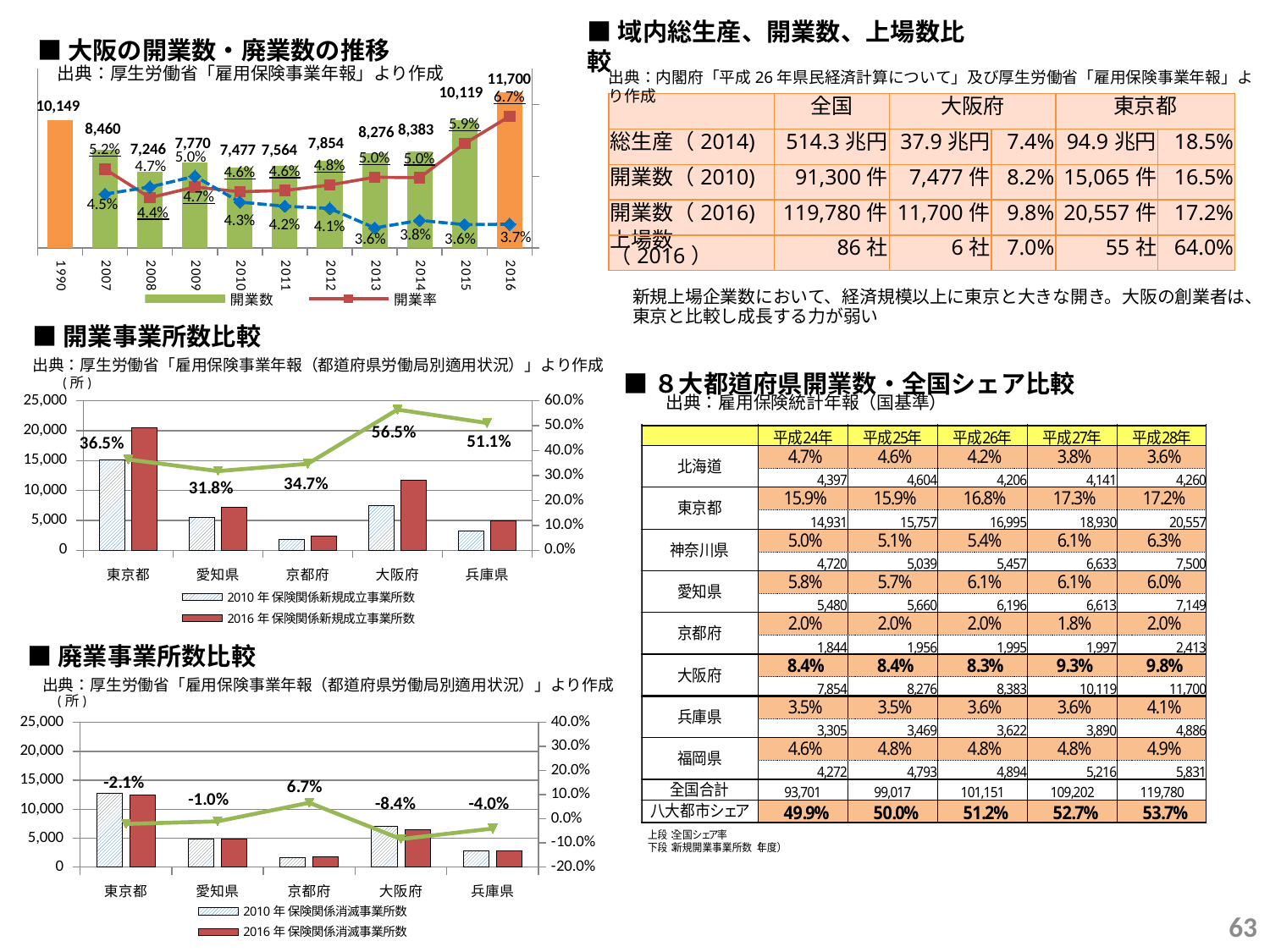
In the chart titled 開業事業所数比較, what is the percentage label shown for 大阪府? 56.5% In the chart titled 大阪の開業数・廃業数の推移, which year has the lowest 開業数 bar? 2008 In the chart titled 廃業事業所数比較, which prefecture has the highest percentage label on the line? 京都府 In the chart titled 大阪の開業数・廃業数の推移, does the 開業率 line rise or fall from 2013 to 2016? rise In the chart titled 開業事業所数比較, is the 2016年 bar for 東京都 greater or less than 15,000? greater In the chart titled 開業事業所数比較, how many series does the legend list? 2 In the chart titled 開業事業所数比較, which prefecture has the lowest percentage label on the line? 愛知県 In the chart titled 大阪の開業数・廃業数の推移, what is the difference in 開業数 between 2016 and 2015? 1,581 In the chart titled 大阪の開業数・廃業数の推移, what is the 開業数 value for 2016? 11,700 In the chart titled 大阪の開業数・廃業数の推移, how many years are shown on the x axis? 11 In the chart titled 大阪の開業数・廃業数の推移, what is the 開業率 value for 2015? 5.9% In the chart titled 廃業事業所数比較, what is the percentage label shown for 大阪府? -8.4%